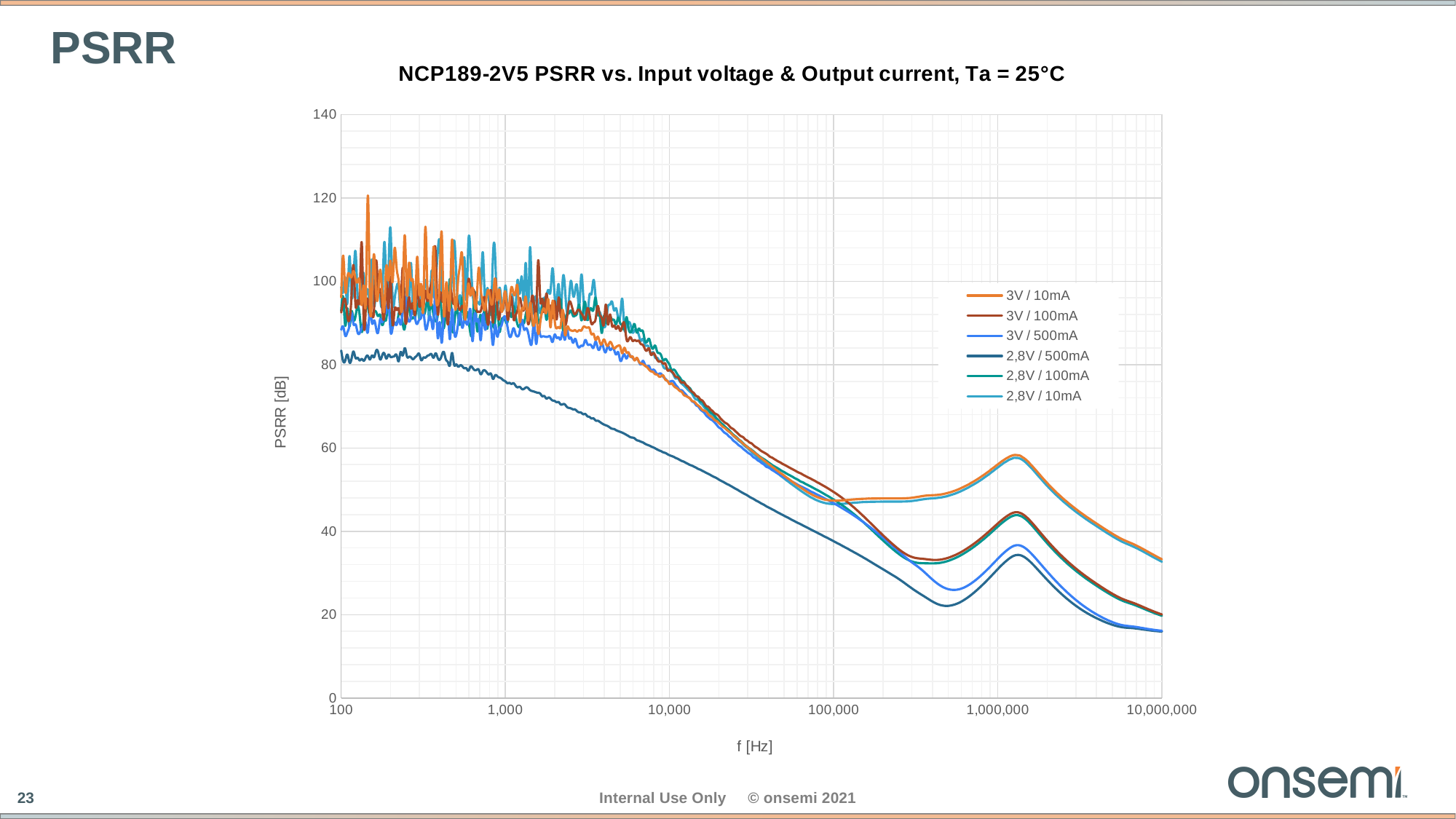
What kind of chart is shown on the slide? line chart Is the PSRR of the 3V / 500mA series at 10,000,000 Hz greater or less than 20 dB? less Is the PSRR of the 2,8V / 500mA series at 100 Hz greater or less than 100 dB? less What is the title of the chart? NCP189-2V5 PSRR vs. Input voltage & Output current, Ta = 25°C Is the peak PSRR of the 3V / 10mA series near 1,000,000 Hz greater or less than 40 dB? greater Which series has the lowest PSRR at 100 Hz? 2,8V / 500mA What is the label of the y axis? PSRR [dB] Overall, does the PSRR rise or fall as frequency increases from 100 Hz to 10,000,000 Hz? fall How many series does the legend list? 6 At 10,000 Hz, which series has the higher PSRR: 3V / 100mA or 2,8V / 500mA? 3V / 100mA At 10,000,000 Hz, which series has the higher PSRR: 3V / 10mA or 3V / 500mA? 3V / 10mA